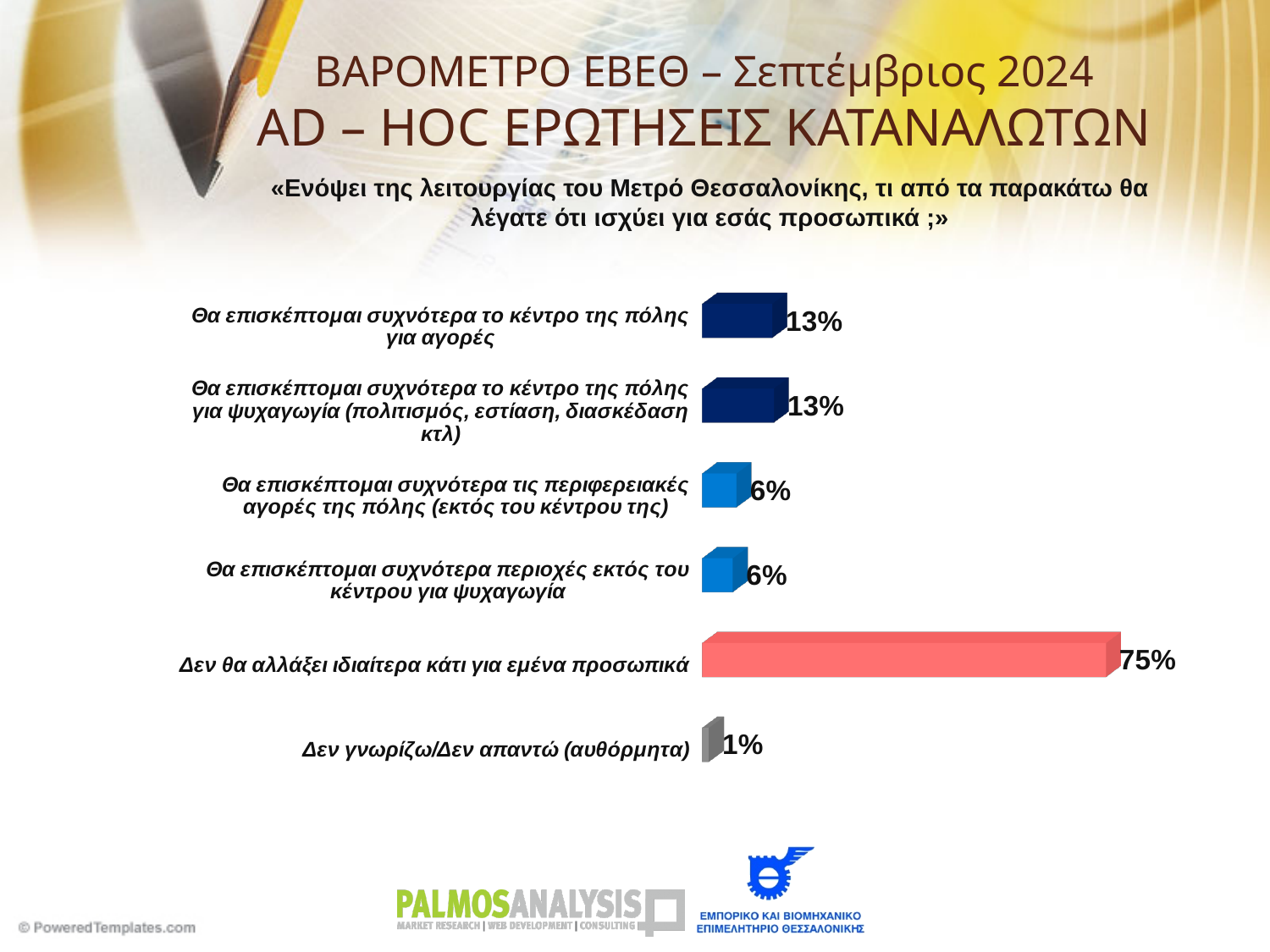
What is the value shown for "Θα επισκέπτομαι συχνότερα το κέντρο της πόλης για αγορές"? 13% What kind of chart is shown on the slide? Bar chart How many response categories are shown in the chart? 6 What percentage of respondents said "Δεν θα αλλάξει ιδιαίτερα κάτι για εμένα προσωπικά"? 75% What is the difference in percentage points between "Δεν θα αλλάξει ιδιαίτερα κάτι για εμένα προσωπικά" and "Θα επισκέπτομαι συχνότερα το κέντρο της πόλης για αγορές"? 62 percentage points What is the value shown for "Θα επισκέπτομαι συχνότερα τις περιφερειακές αγορές της πόλης (εκτός του κέντρου της)"? 6% Which response category has the lowest value in the chart? Δεν γνωρίζω/Δεν απαντώ (αυθόρμητα) What is the difference in percentage points between "Θα επισκέπτομαι συχνότερα το κέντρο της πόλης για αγορές" and "Θα επισκέπτομαι συχνότερα τις περιφερειακές αγορές της πόλης (εκτός του κέντρου της)"? 7 percentage points Which response category has the highest value in the chart? Δεν θα αλλάξει ιδιαίτερα κάτι για εμένα προσωπικά What colour is the bar for "Δεν θα αλλάξει ιδιαίτερα κάτι για εμένα προσωπικά"? Red (salmon) What percentage is shown for "Δεν γνωρίζω/Δεν απαντώ (αυθόρμητα)"? 1% Which is larger: the value for "Θα επισκέπτομαι συχνότερα το κέντρο της πόλης για ψυχαγωγία (πολιτισμός, εστίαση, διασκέδαση κτλ)" or the value for "Θα επισκέπτομαι συχνότερα περιοχές εκτός του κέντρου για ψυχαγωγία"? Θα επισκέπτομαι συχνότερα το κέντρο της πόλης για ψυχαγωγία (πολιτισμός, εστίαση, διασκέδαση κτλ)